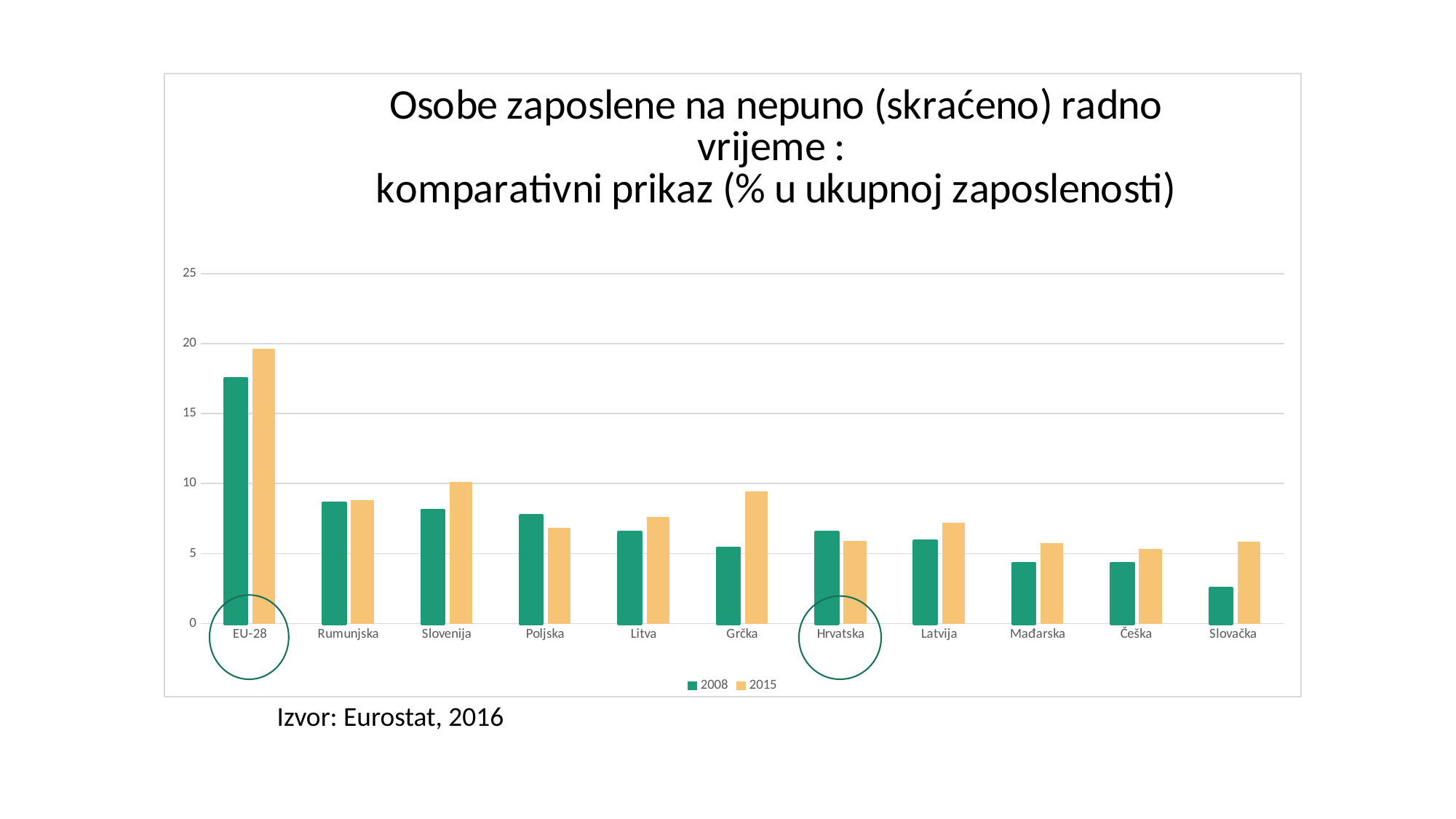
Which category has the highest value for 2015? EU-28 What kind of chart is shown on the slide? bar chart Is the 2015 value for Grčka greater or less than 10? less Is the 2015 value for EU-28 greater or less than 15? greater Which years are listed in the legend? 2008 and 2015 For Poljska, which is larger: the 2008 value or the 2015 value? 2008 Which category has the lowest value for 2008? Slovačka For Hrvatska, which is larger: the 2008 value or the 2015 value? 2008 For Grčka, which is larger: the 2008 value or the 2015 value? 2015 Is the 2008 value for Slovačka greater or less than 5? less How many series does the legend list? 2 How many countries/regions are shown on the x axis of the chart? 11